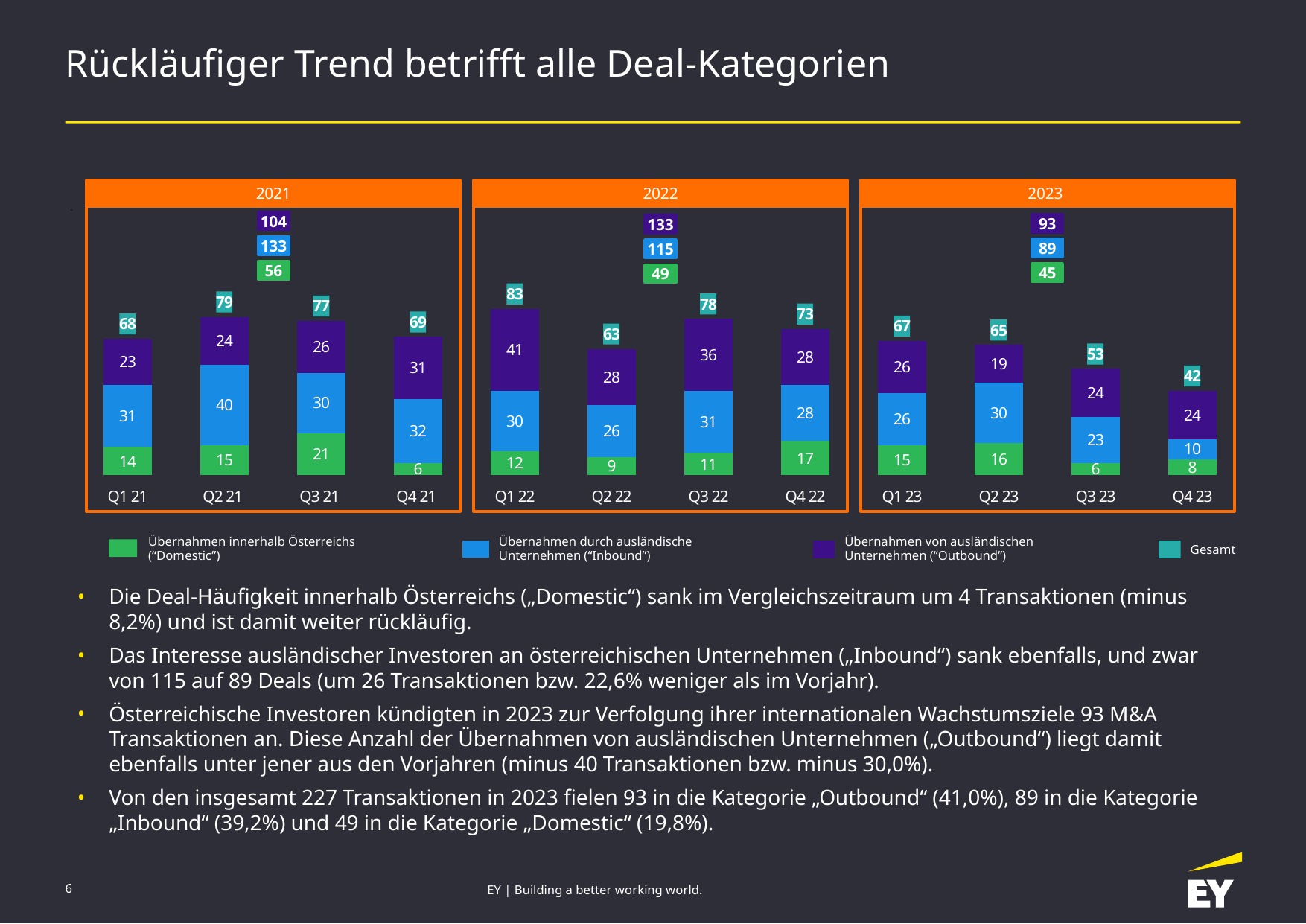
In the 2023 chart, what is the Domestic value for Q4 23? 8 In the 2023 chart, do the Gesamt (total) values rise or fall from Q1 23 to Q4 23? Fall In the 2022 chart, what is the total of the stacked bar for Q3 22? 78 How many series does the legend list? 4 How many quarters are shown in the 2023 chart? 4 In the 2023 chart, is the Outbound value for Q1 23 or Q2 23 larger? Q1 23 In the 2022 chart, which quarter has the highest Gesamt (total) value? Q1 22 In the 2023 chart, which quarter has the lowest Gesamt (total) value? Q4 23 What kind of chart is used on the slide? Stacked bar chart In the 2022 chart, what is the Outbound value for Q1 22? 41 In the 2021 chart, what is the Inbound value for Q2 21? 40 In the 2021 chart, what is the difference between the Inbound values for Q2 21 and Q3 21? 10